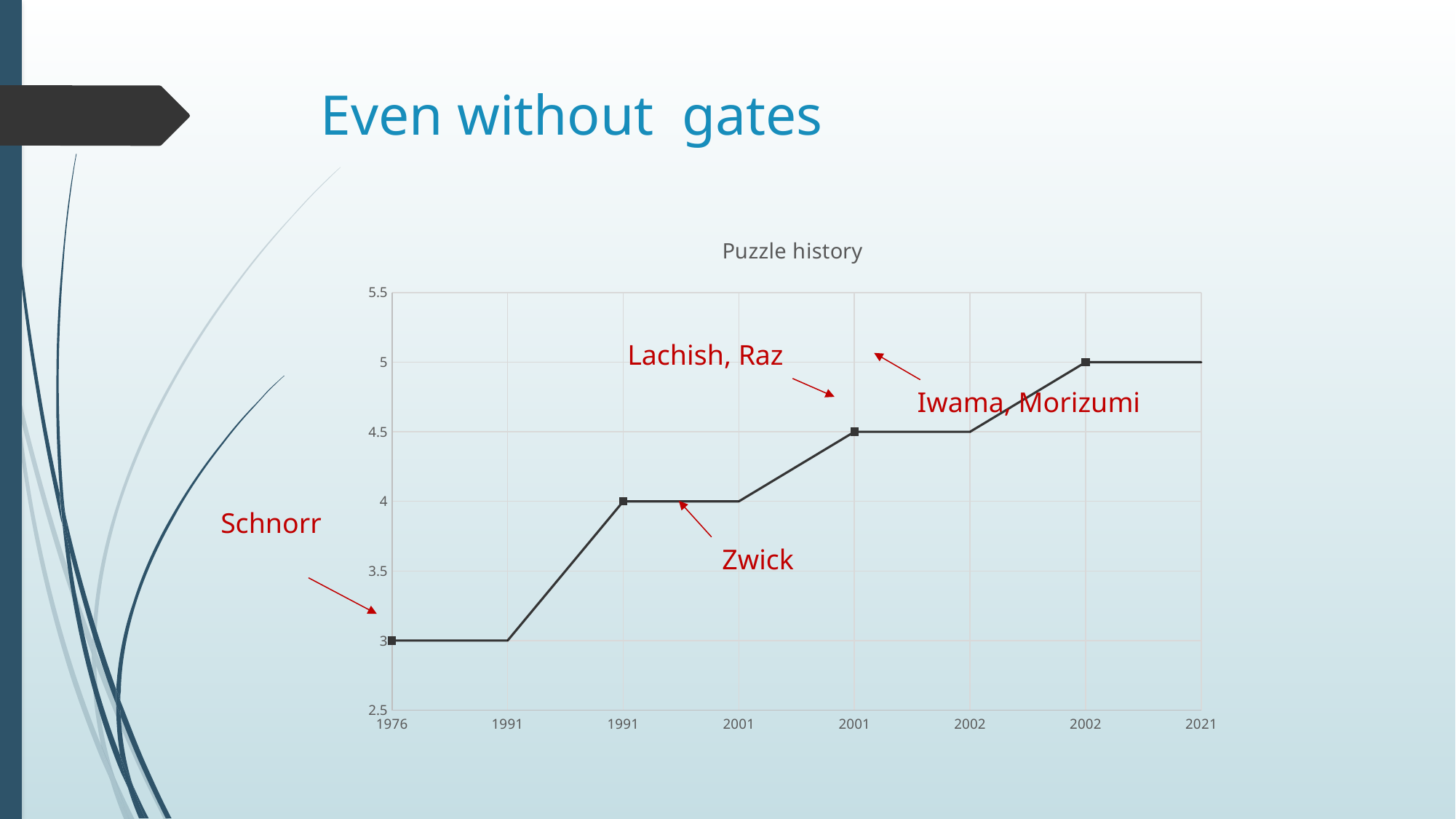
What kind of chart is shown on the slide? line chart Is the value for 2021 in the Puzzle history chart greater or less than 4.5? greater What is the value plotted for 1976 in the Puzzle history chart? 3 Which has the larger value in the Puzzle history chart, 1976 or 2021? 2021 What is the lowest value of the line in the Puzzle history chart? 3 What is the highest value reached by the line in the Puzzle history chart? 5 What is the value plotted for 2021 in the Puzzle history chart? 5 What is the difference between the value at 2021 and the value at 1976 in the Puzzle history chart? 2 Which name is annotated with an arrow pointing at the first data point (1976) of the chart? Schnorr Do the values in the Puzzle history chart rise or fall from left to right along the x axis? rise How many data points are plotted along the x axis of the Puzzle history chart? 8 What is the title of the chart? Puzzle history